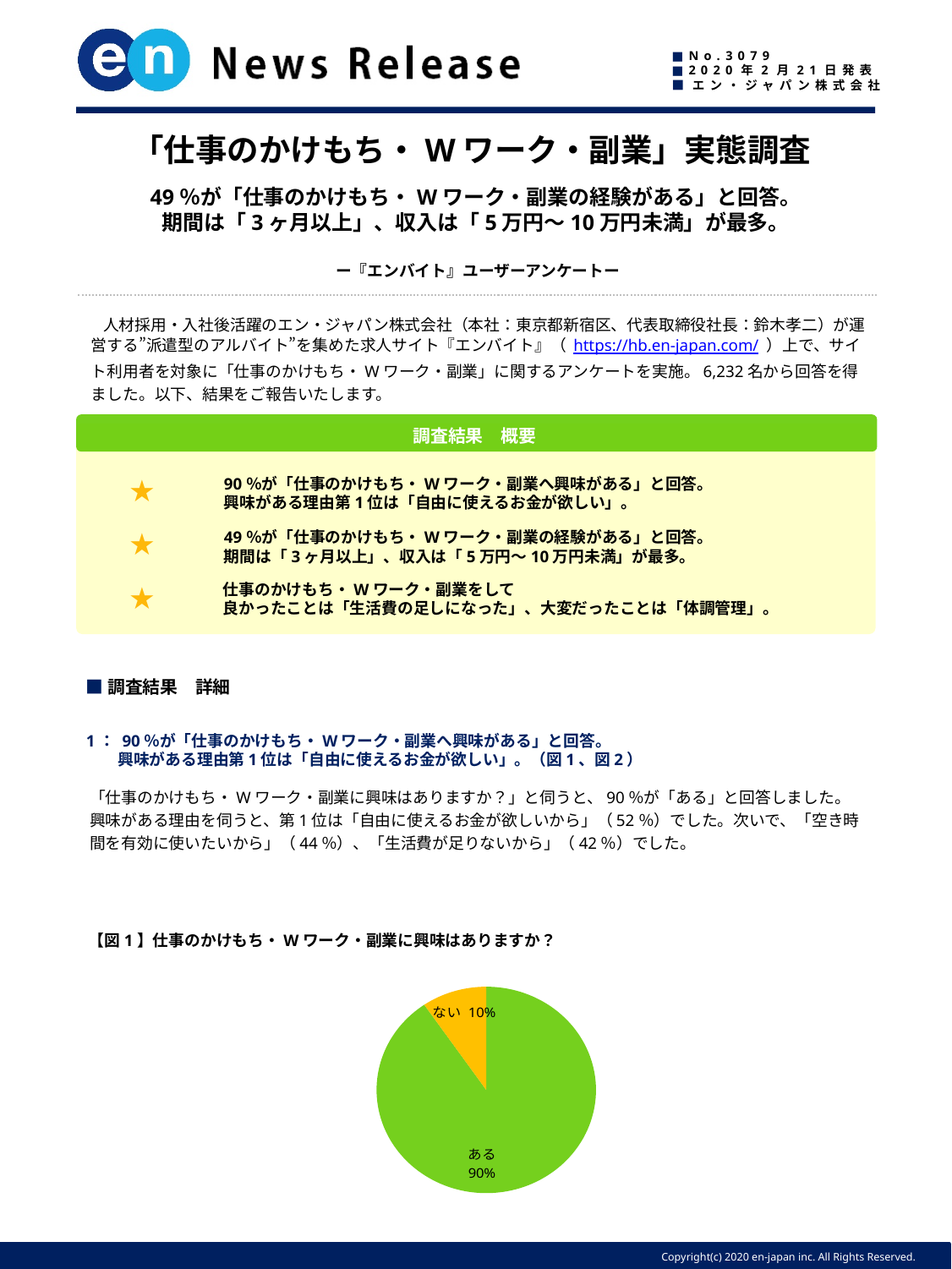
In the pie chart 【図1】, which is larger, the share for 「ある」 or the share for 「ない」? ある What kind of chart is shown under 【図1】? pie chart In the pie chart 【図1】, what is the difference in percentage points between 「ある」 and 「ない」? 80 In the pie chart 【図1】, how many slices are there? 2 In the pie chart 【図1】, what percentage of respondents answered 「ない」? 10% What is the title of the pie chart shown on the slide? 【図1】仕事のかけもち・Wワーク・副業に興味はありますか？ In the pie chart 【図1】, which answer has the largest share? ある In the pie chart 【図1】, what colour is the 「ある」 slice? green In the pie chart 【図1】, which answer has the smallest share? ない In the pie chart 【図1】, what share of the pie does the 「ない」 slice represent? 10% In the pie chart 【図1】, what percentage of respondents answered 「ある」? 90%